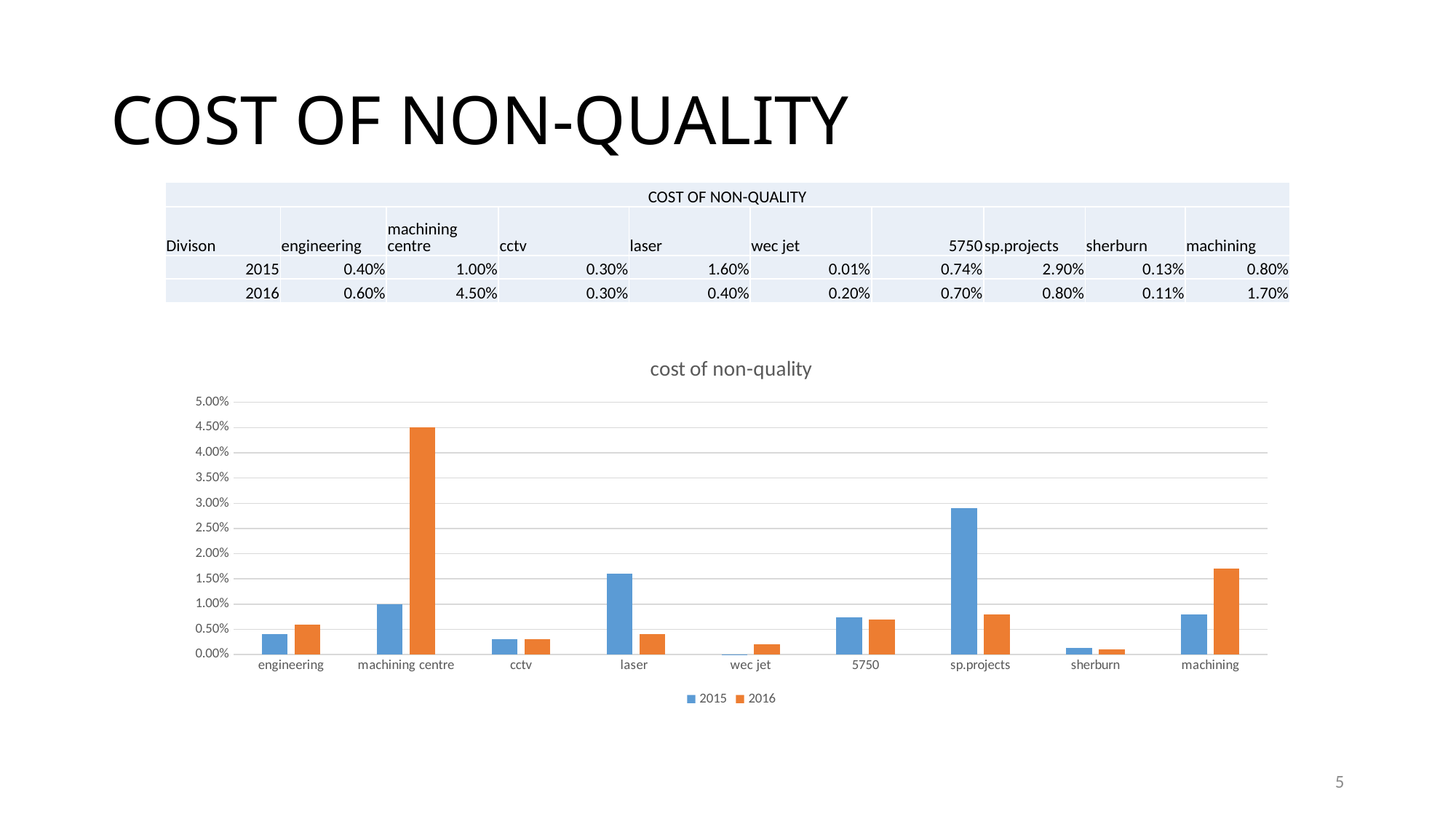
What type of chart is the cost of non-quality chart? bar chart Which colour represents 2016 in the cost of non-quality chart? orange In the cost of non-quality chart, is the 2015 value for laser larger than the 2016 value for laser? Yes, 2015 (1.60%) is larger What is the 2015 value for sp.projects in the cost of non-quality chart? 2.90% How many divisions are shown on the x axis of the cost of non-quality chart? 9 How many series does the legend of the cost of non-quality chart list? 2 What is the 2016 value for machining centre in the cost of non-quality chart? 4.50% Which division has the lowest 2015 value in the cost of non-quality chart? wec jet Is the 2015 value for sp.projects in the cost of non-quality chart greater or less than 2.50%? greater What is the difference between the 2016 and 2015 values for machining in the cost of non-quality chart? 0.90% Which division has the highest 2016 value in the cost of non-quality chart? machining centre What is the 2015 value for laser in the cost of non-quality chart? 1.60%